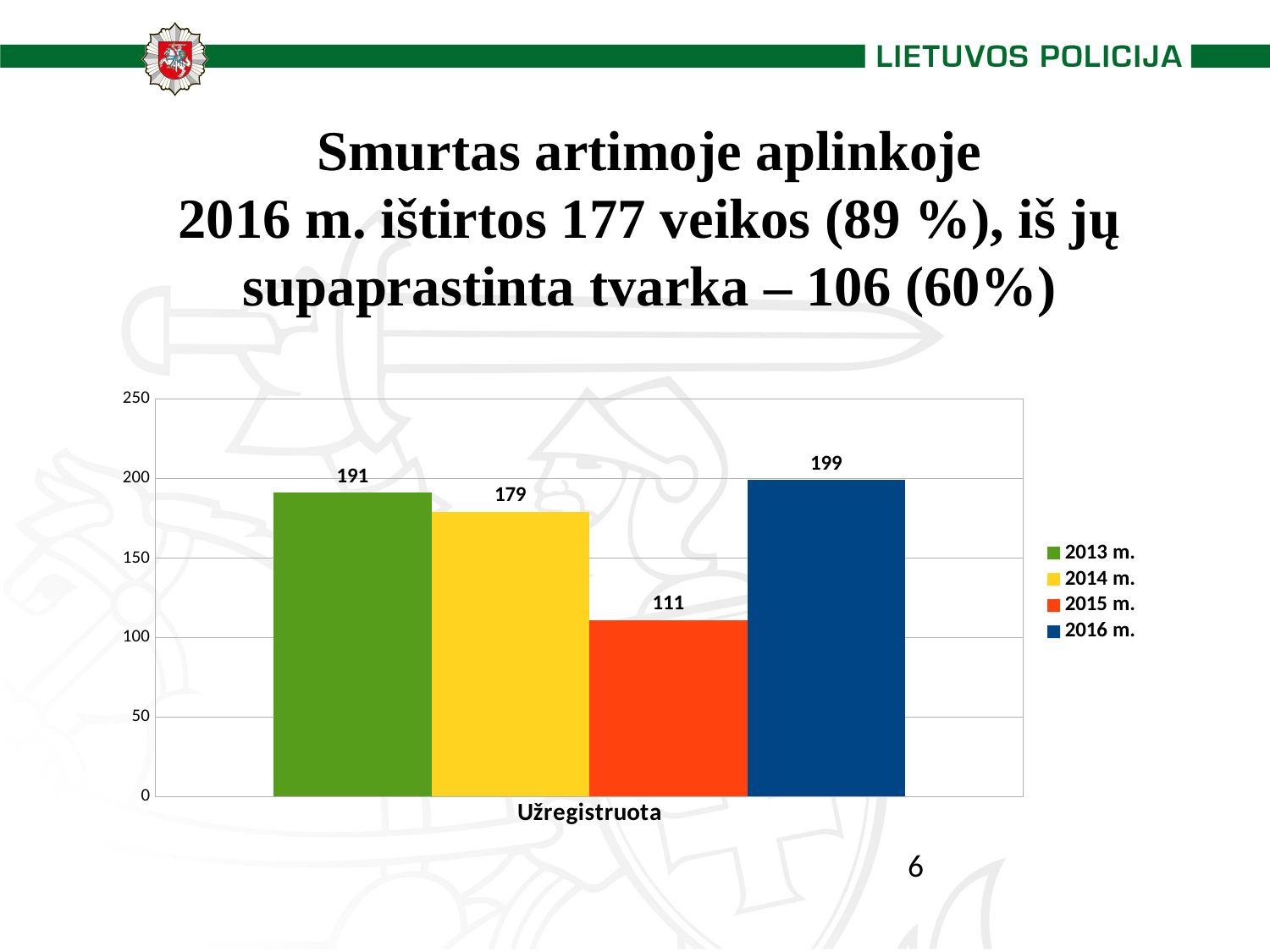
Which year has the highest value in the chart? 2016 m. Which year has the lowest value in the chart? 2015 m. What is the difference between the values for 2016 m. and 2015 m.? 88 How many series does the legend list? 4 Which is larger, the value for 2013 m. or the value for 2014 m.? 2013 m. What is the value for 2014 m. in the Užregistruota chart? 179 What kind of chart is shown on the slide? bar chart What is the value for 2013 m. in the Užregistruota chart? 191 What is the value for 2015 m. in the Užregistruota chart? 111 What colour is the bar for 2015 m.? orange-red What is the difference between the values for 2013 m. and 2014 m.? 12 What is the value for 2016 m. in the Užregistruota chart? 199